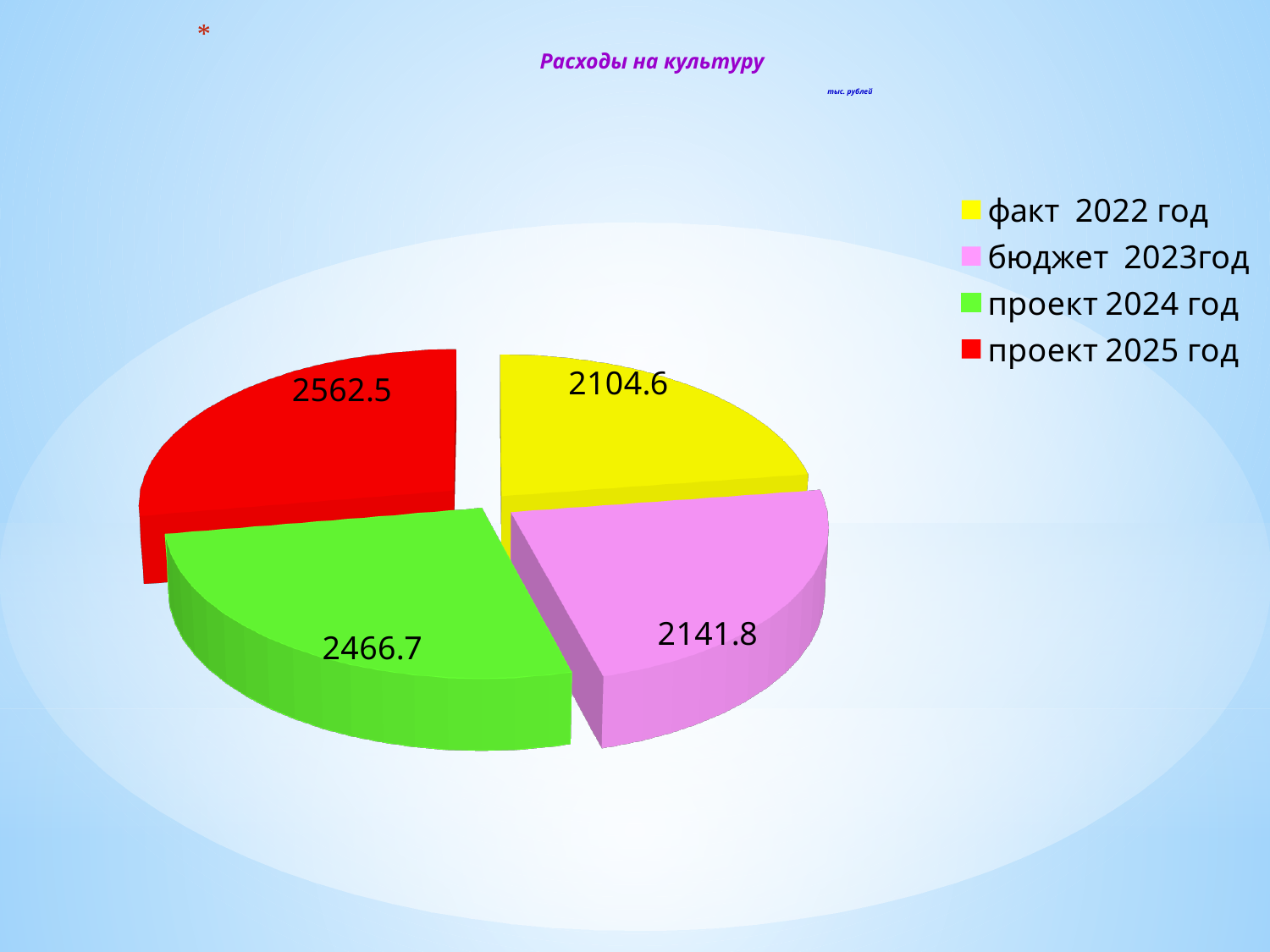
How many slices does the pie chart have? 4 What kind of chart is shown on the slide? pie chart What is the value for факт 2022 год? 2104.6 What is the title of the chart? Расходы на культуру Which is larger, бюджет 2023год or проект 2024 год? проект 2024 год How many entries does the legend list? 4 Which category has the largest slice? проект 2025 год What is the value for проект 2024 год? 2466.7 Which category has the smallest slice? факт 2022 год What is the difference between проект 2025 год and факт 2022 год? 457.9 What is the value for проект 2025 год? 2562.5 What is the value for бюджет 2023год? 2141.8